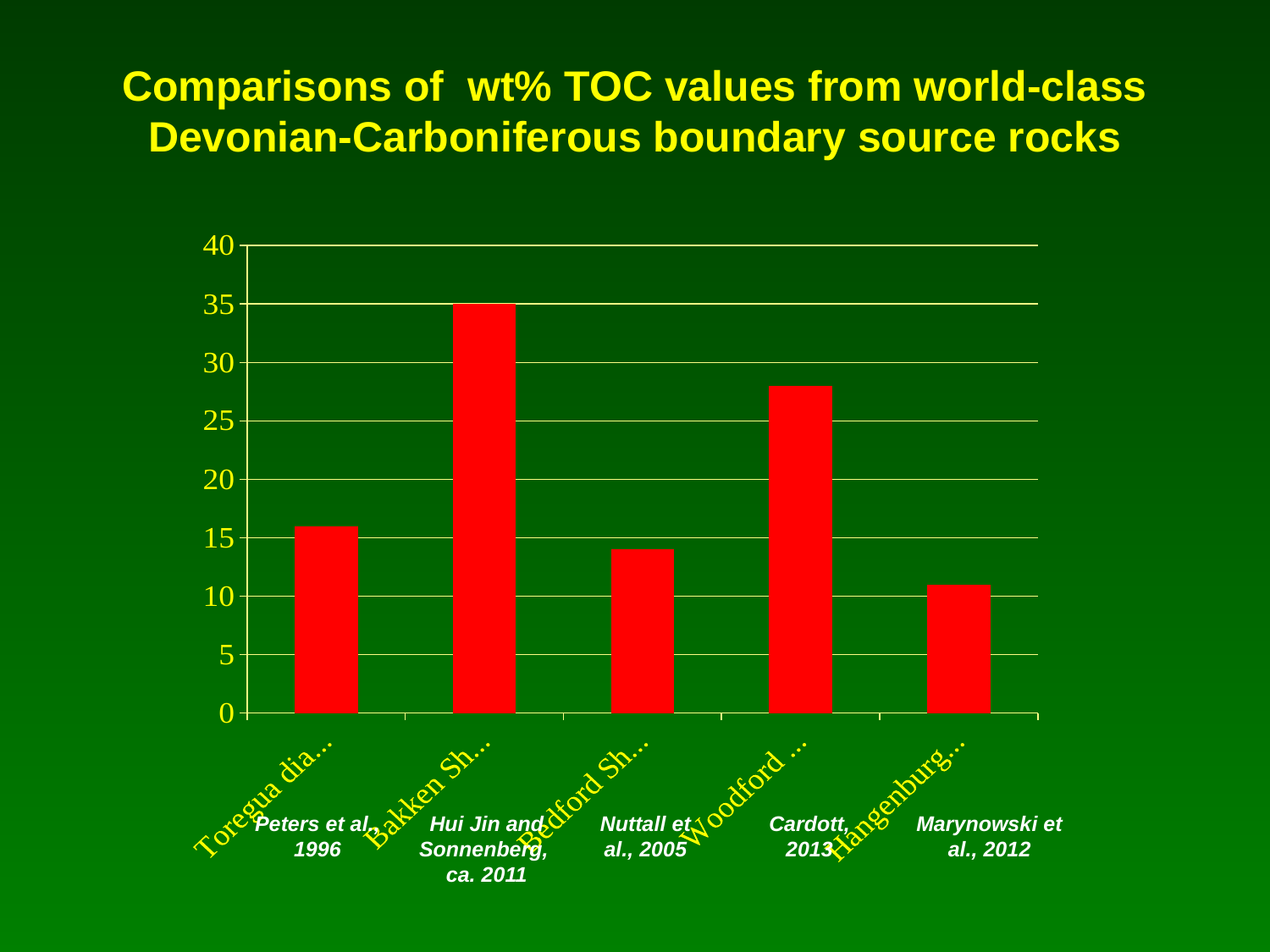
What kind of chart is shown on the slide? bar chart How many bars (categories) are plotted in the chart? 5 Is the value for Hangenburg… greater or less than 10? greater What is the wt% TOC value for the Bakken Sh… bar? 35 Is the value for Woodford … greater or less than 25? greater Which category has the highest wt% TOC value in the chart? Bakken Sh… Is the value for Bedford Sh… greater or less than 15? less Which has the larger value, Bedford Sh… or Hangenburg…? Bedford Sh… Which has the larger value, Woodford … or Toregua dia…? Woodford … What colour are the bars in the chart? red Which category has the lowest wt% TOC value in the chart? Hangenburg…